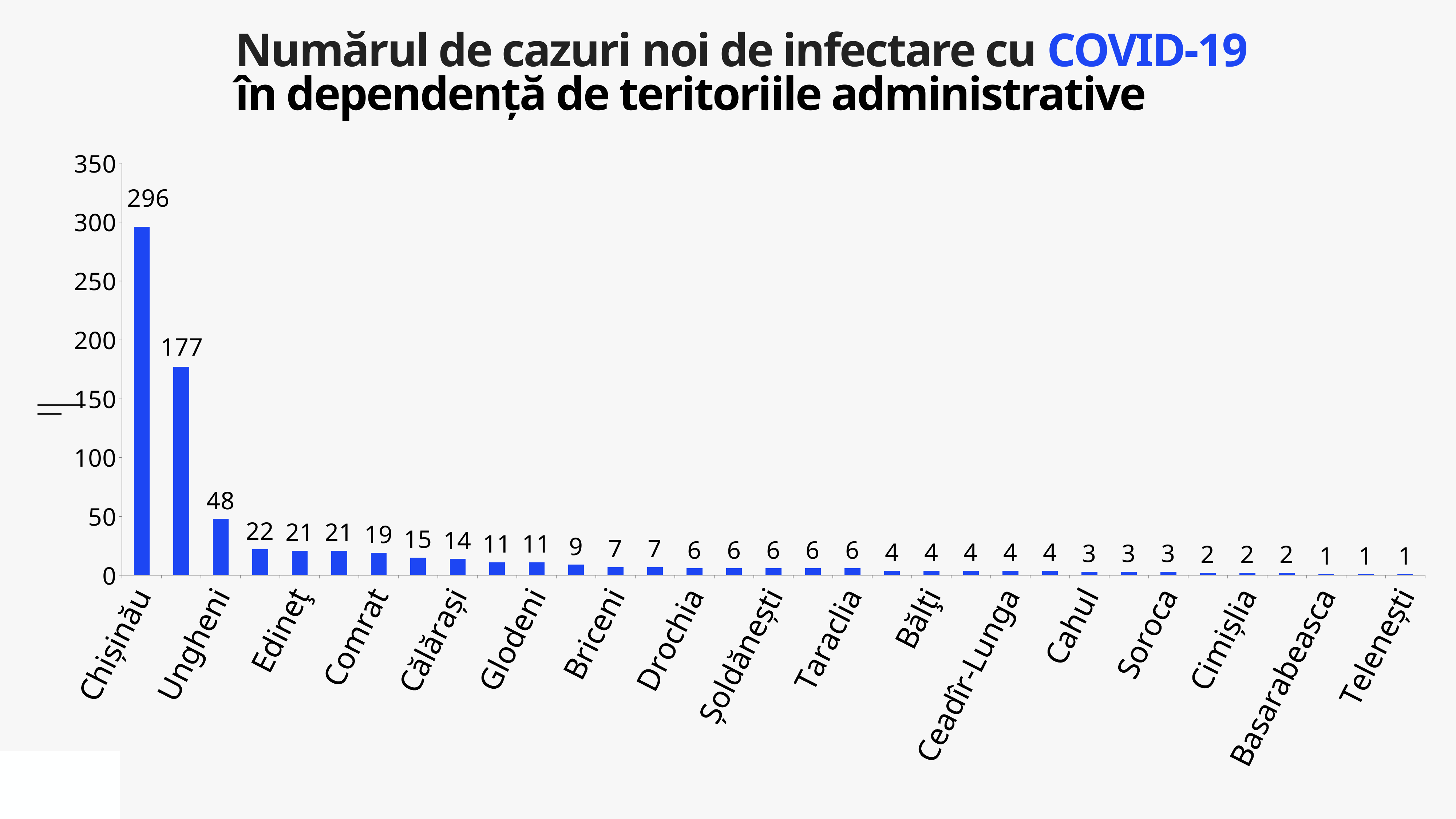
What is the highest value shown on the vertical axis? 350 What kind of chart is shown on the slide? bar chart How many new COVID-19 cases are shown for Chișinău? 296 What is the lowest value shown by a data label in the chart? 1 How many bars are plotted in the chart? 33 Is the value for Chișinău greater or less than 250? greater What is the difference between the two tallest bars in the chart? 119 What is the value of the second tallest bar in the chart? 177 Do the values rise or fall moving from left to right along the x axis? fall What colour are the bars in the chart? blue Which is larger, the value for Chișinău or the value for Ungheni? Chișinău Which territory has the highest number of new COVID-19 cases? Chișinău